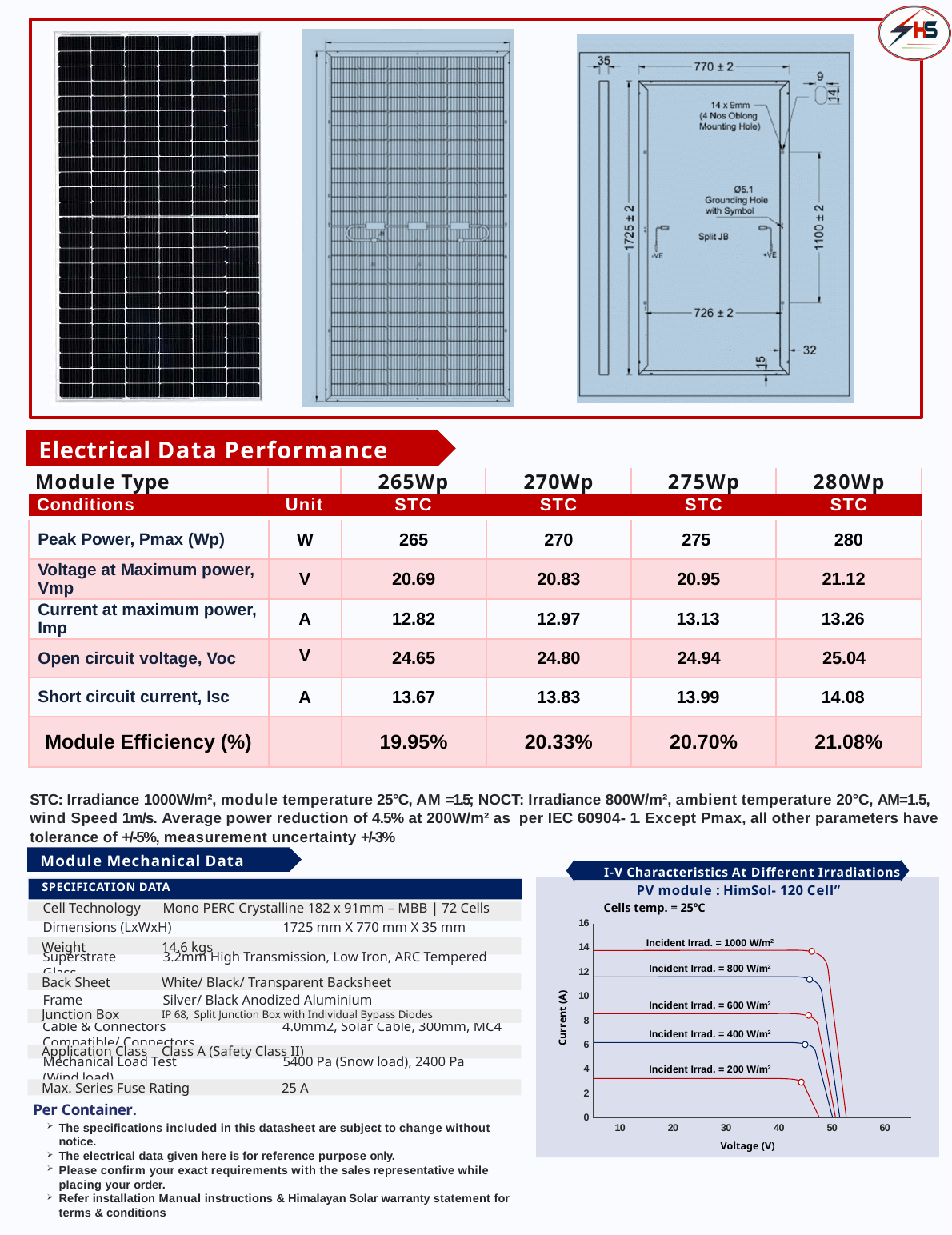
On the I-V Characteristics chart, is the current of the 1000 W/m² curve at 10 V greater or less than 12 A? greater On the I-V Characteristics chart, does the current rise or fall as voltage increases beyond about 45 V? fall What is the y-axis label of the I-V Characteristics chart? Current (A) On the I-V Characteristics chart, which irradiance curve has the highest current? Incident Irrad. = 1000 W/m² How many irradiance curves are plotted on the I-V Characteristics chart? 5 What kind of chart is the I-V Characteristics At Different Irradiations chart? line chart On the I-V Characteristics chart, which irradiance curve has the lowest current? Incident Irrad. = 200 W/m² On the I-V Characteristics chart, is the current of the 600 W/m² curve at 20 V greater or less than 6 A? greater On the I-V Characteristics chart, is the current of the 800 W/m² curve at 20 V greater or less than 10 A? greater On the I-V Characteristics chart, which curve shows a higher current: 800 W/m² or 600 W/m²? 800 W/m² What cell temperature is stated for the I-V Characteristics chart? 25°C